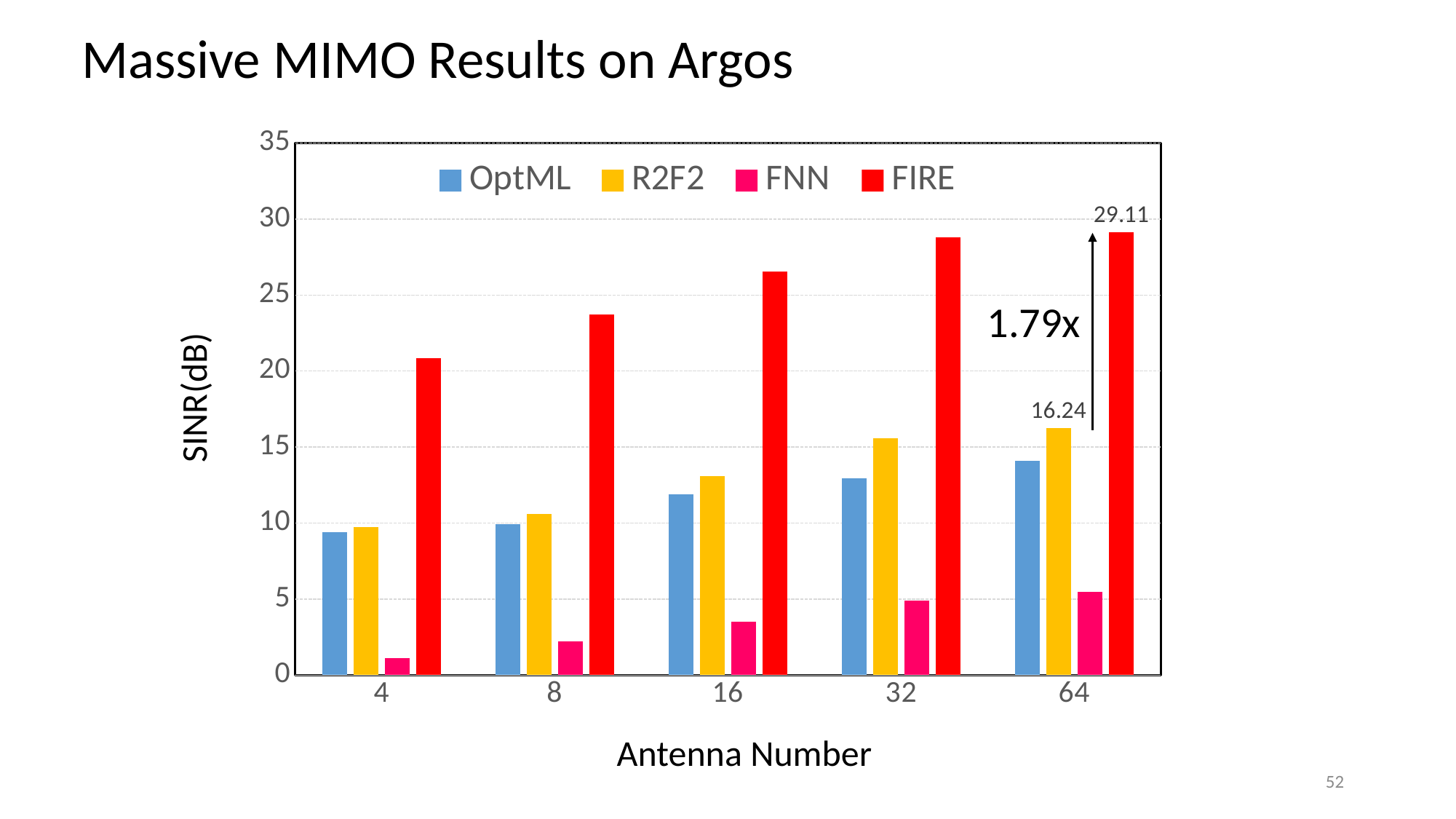
What is the difference between the FIRE and R2F2 values at antenna number 64? 12.87 Which is larger at antenna number 16: OptML or R2F2? R2F2 What is the SINR value for R2F2 at antenna number 64? 16.24 Do the FIRE values rise or fall as the antenna number increases? rise What is the SINR value for FIRE at antenna number 64? 29.11 Which series has the highest SINR at antenna number 32? FIRE Is the value for FIRE at antenna number 16 greater or less than 25? greater What kind of chart is shown on the slide? bar chart How many antenna number categories are shown on the x axis? 5 How many series does the legend list? 4 Is the value for OptML at antenna number 8 greater or less than 15? less Which series has the lowest SINR at antenna number 4? FNN